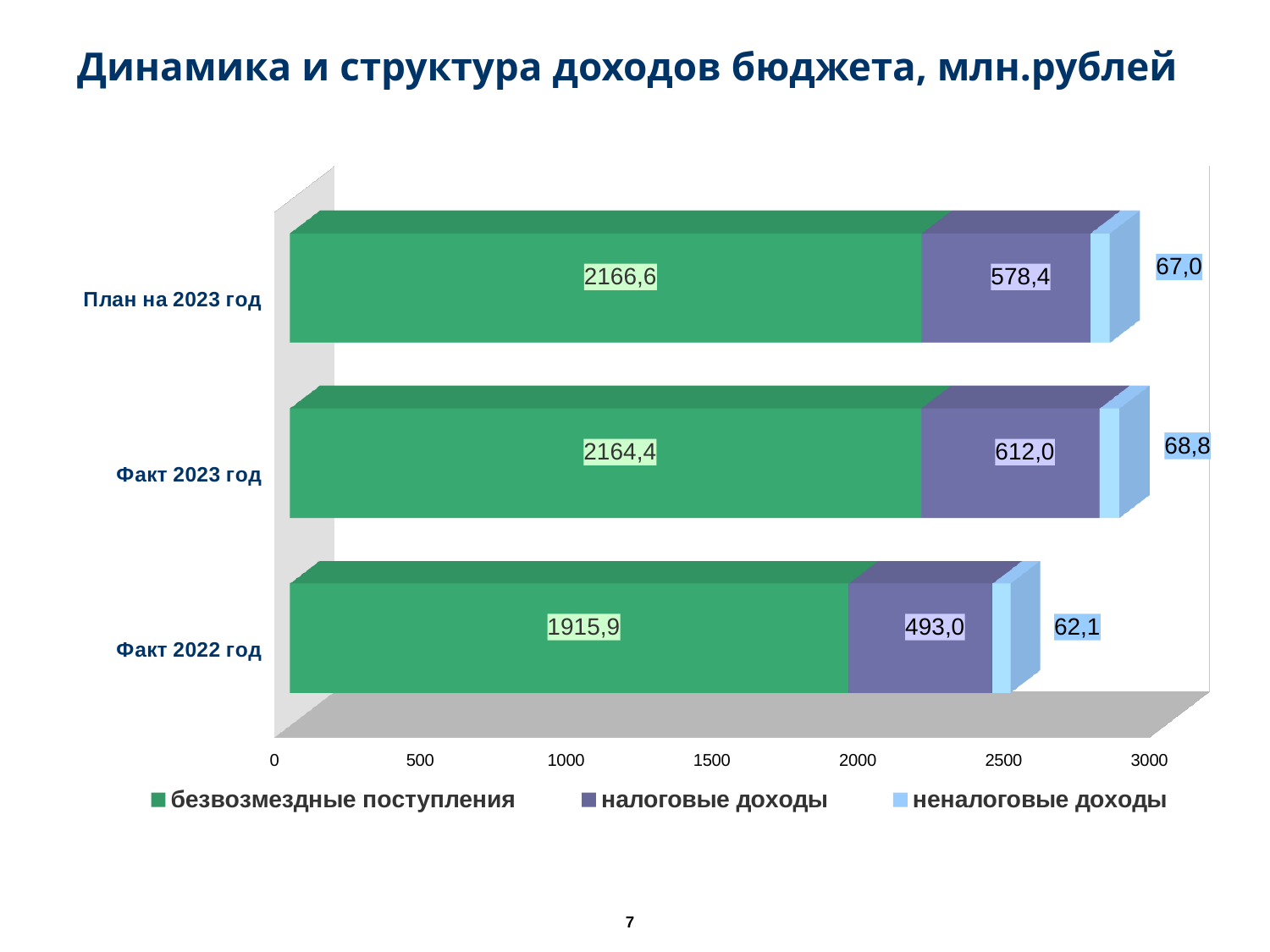
What is the difference between налоговые доходы for Факт 2023 год and План на 2023 год? 33,6 What is the total of the stacked bar for Факт 2022 год? 2471,0 How many series does the legend list? 3 What is the value of безвозмездные поступления for План на 2023 год? 2166,6 What kind of chart is shown on the slide? Stacked bar chart Which category has the highest value for налоговые доходы? Факт 2023 год What is the value of неналоговые доходы for Факт 2023 год? 68,8 Which is larger: неналоговые доходы for Факт 2023 год or for Факт 2022 год? Факт 2023 год How many categories are shown on the chart? 3 What is the total of the stacked bar for Факт 2023 год? 2845,2 Which category has the lowest value for безвозмездные поступления? Факт 2022 год What is the value of налоговые доходы for Факт 2022 год? 493,0